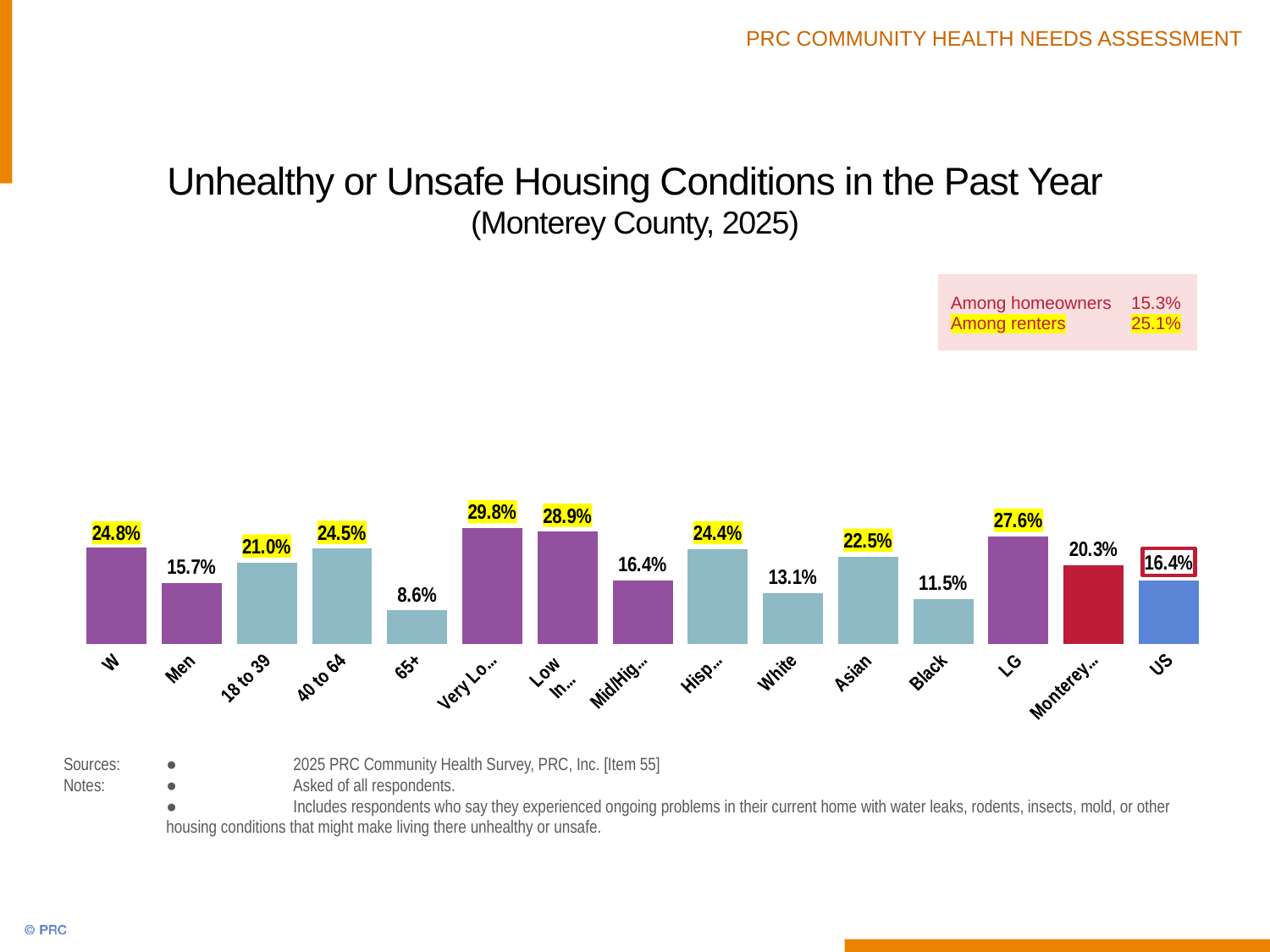
According to the box on the slide, what is the value among renters? 25.1% How many bars are shown in the chart? 15 What is the value for Black respondents? 11.5% Which is larger, the value for White or the value for Black? White What is the difference between the values for Asian and US? 6.1 percentage points Which category has the lowest value? 65+ What is the difference between the values for 40 to 64 and 18 to 39? 3.5 percentage points What is the value for Men? 15.7% What is the value for US? 16.4% What is the value for Asian respondents? 22.5% What kind of chart is shown on the slide? Bar chart What is the value for the 65+ age group? 8.6%